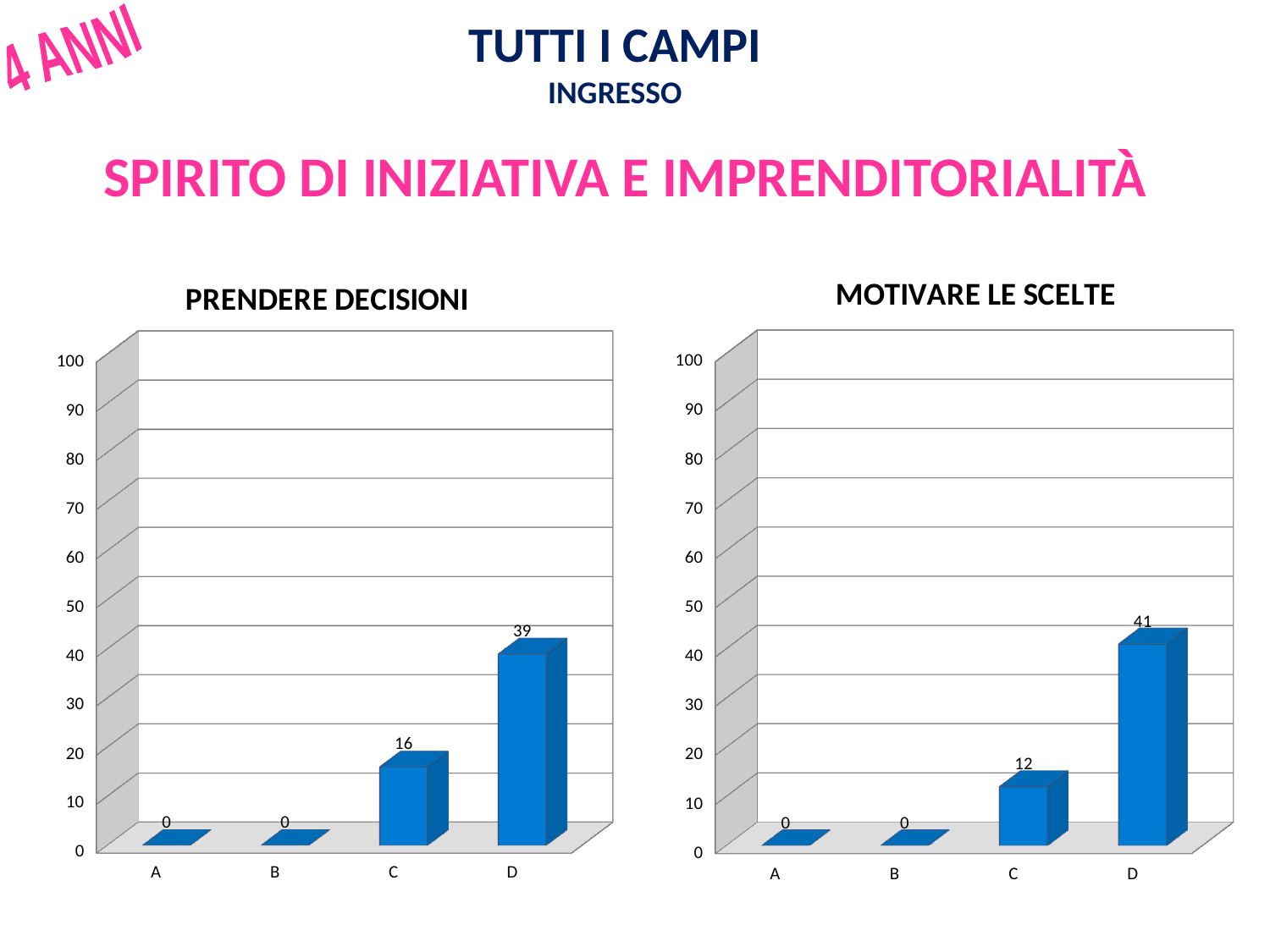
In the MOTIVARE LE SCELTE chart, which category has the highest value? D What kind of chart is the PRENDERE DECISIONI chart? Bar chart In the MOTIVARE LE SCELTE chart, what is the value for category C? 12 In the PRENDERE DECISIONI chart, what is the value for category A? 0 In the PRENDERE DECISIONI chart, what is the difference between the values for D and C? 23 In the MOTIVARE LE SCELTE chart, what is the value for category D? 41 In the PRENDERE DECISIONI chart, what is the value for category C? 16 Which is larger: the value for D in the PRENDERE DECISIONI chart or the value for D in the MOTIVARE LE SCELTE chart? D in MOTIVARE LE SCELTE How many categories are shown on the x axis of the MOTIVARE LE SCELTE chart? 4 In the PRENDERE DECISIONI chart, which category has the highest value? D In the MOTIVARE LE SCELTE chart, what is the difference between the values for D and C? 29 In the PRENDERE DECISIONI chart, what is the value for category D? 39